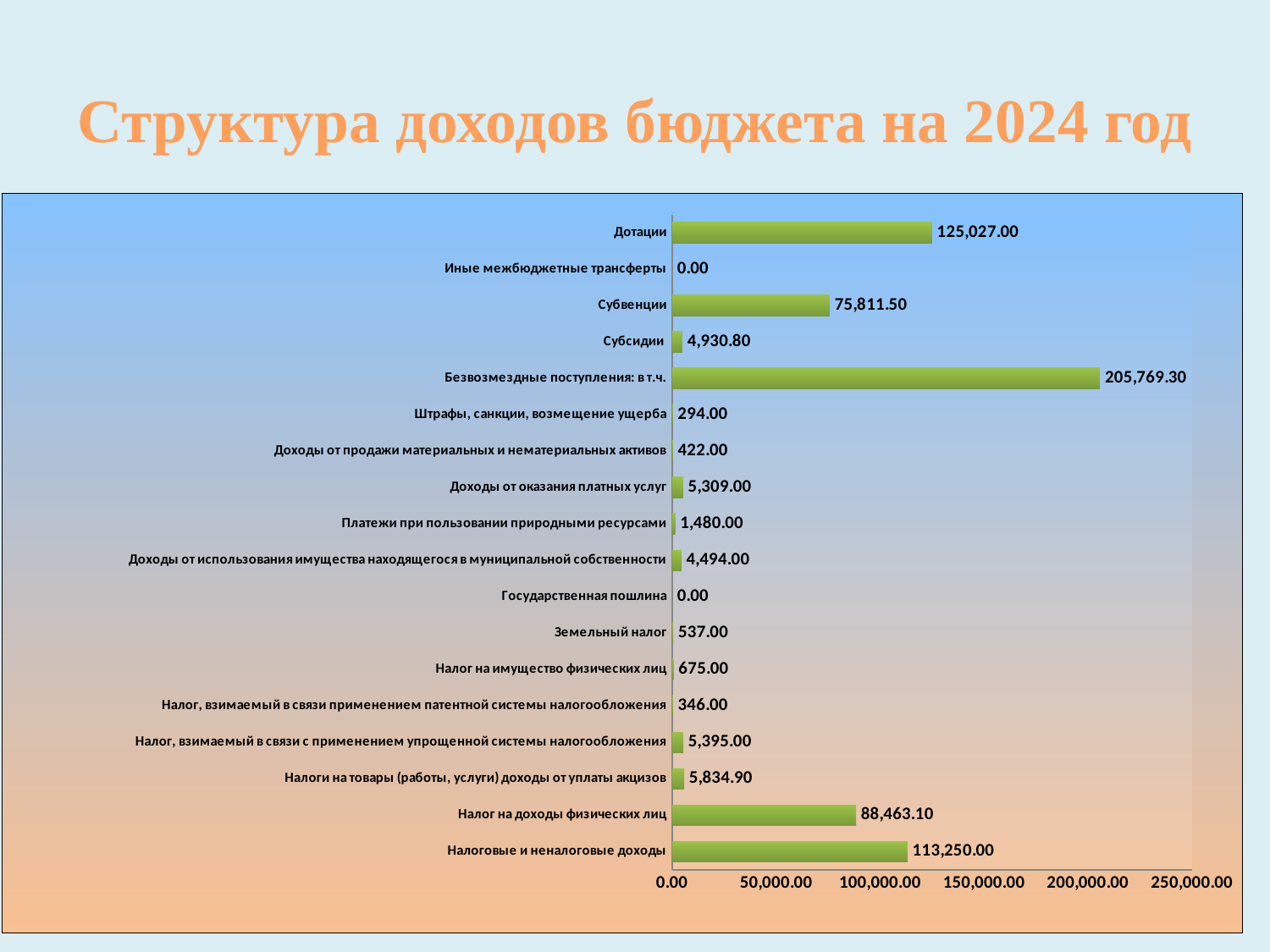
What is the value for Государственная пошлина? 0.00 What is the value for Дотации? 125,027.00 Which is larger, the value for Дотации or the value for Налоговые и неналоговые доходы? Дотации Is the value for Субвенции greater or less than 100,000.00? less What kind of chart is shown on the slide? bar chart Which category has the highest value? Безвозмездные поступления: в т.ч. What is the value for Субвенции? 75,811.50 What is the difference between the values for Налоговые и неналоговые доходы and Налог на доходы физических лиц? 24,786.90 How many categories are shown in the chart? 18 What is the difference between the values for Дотации and Субвенции? 49,215.50 What is the value for Налоги на товары (работы, услуги) доходы от уплаты акцизов? 5,834.90 What is the value for Налог на доходы физических лиц? 88,463.10